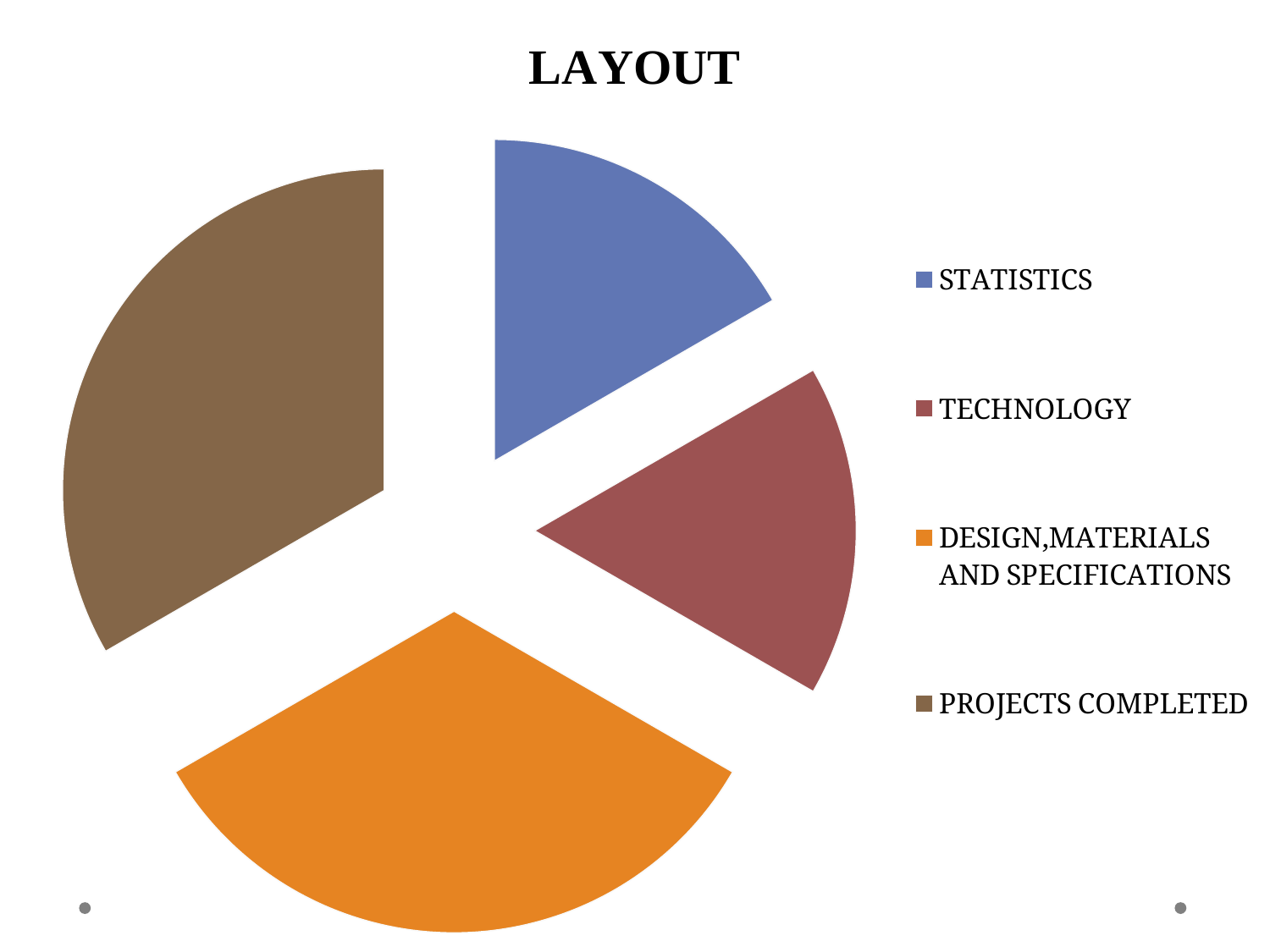
Which slice is larger, DESIGN,MATERIALS AND SPECIFICATIONS or TECHNOLOGY? DESIGN,MATERIALS AND SPECIFICATIONS Which category is shown in orange? DESIGN,MATERIALS AND SPECIFICATIONS What is the title of the chart? LAYOUT Which slice is larger, PROJECTS COMPLETED or STATISTICS? PROJECTS COMPLETED What kind of chart is shown on the slide? pie chart How many slices does the pie chart have? 4 Which slice is larger, PROJECTS COMPLETED or DESIGN,MATERIALS AND SPECIFICATIONS? Neither; they are the same size How many entries does the legend list? 4